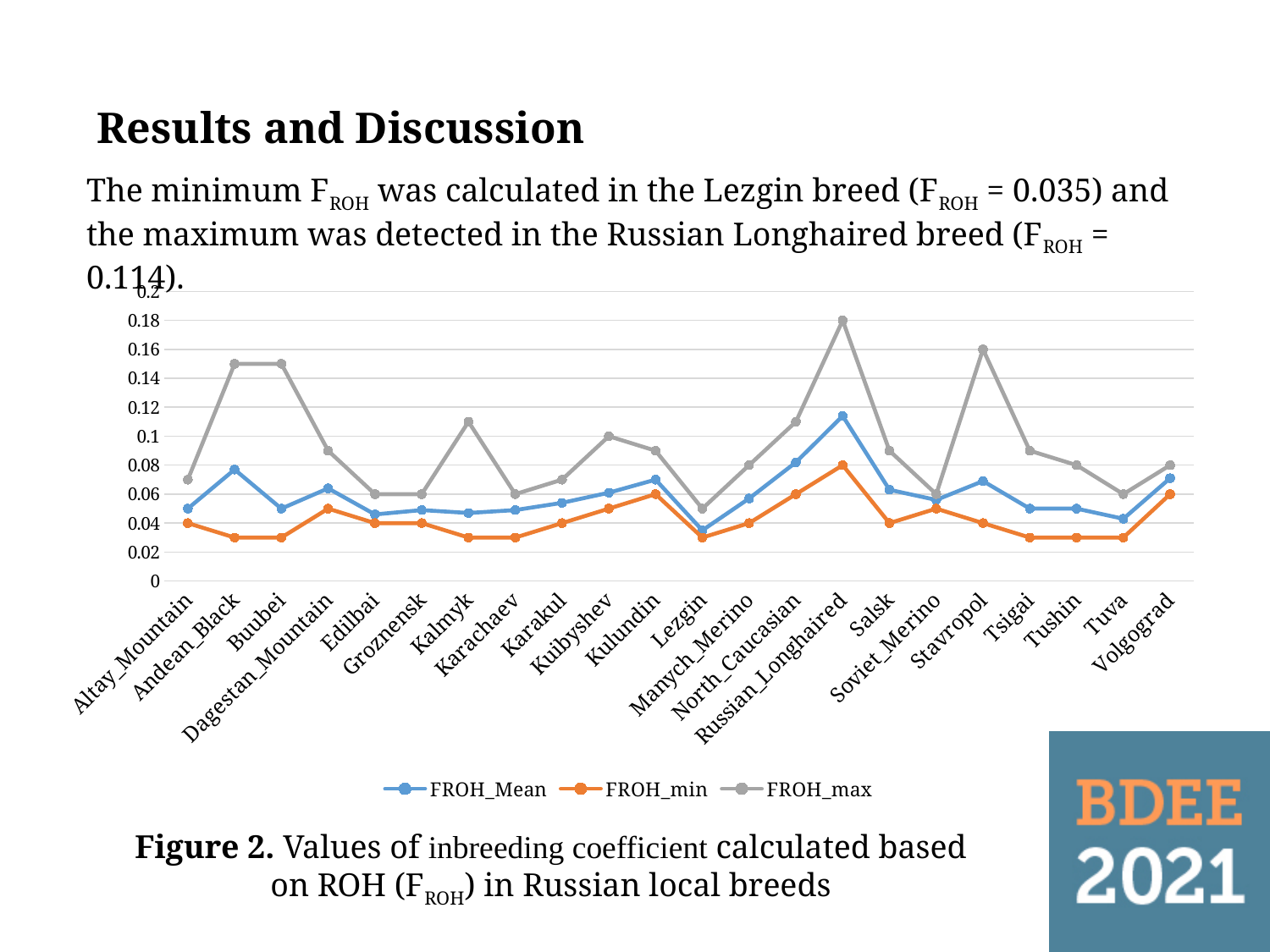
How many breeds are plotted along the x axis? 22 Which is larger, the FROH_max value for Andean_Black or for Edilbai? Andean_Black Which breed has the highest FROH_max value? Russian_Longhaired Is the FROH_max value for Stavropol greater or less than 0.14? greater What kind of chart is shown on the slide? line chart Is the FROH_Mean value for Lezgin greater or less than 0.04? less What is the FROH_max value for Russian_Longhaired? 0.18 Which breed has the highest FROH_Mean value? Russian_Longhaired Which is larger, the FROH_Mean value for Stavropol or for Tsigai? Stavropol Which breed has the lowest FROH_Mean value? Lezgin What colour is the FROH_min line in the chart? orange How many series does the legend list? 3